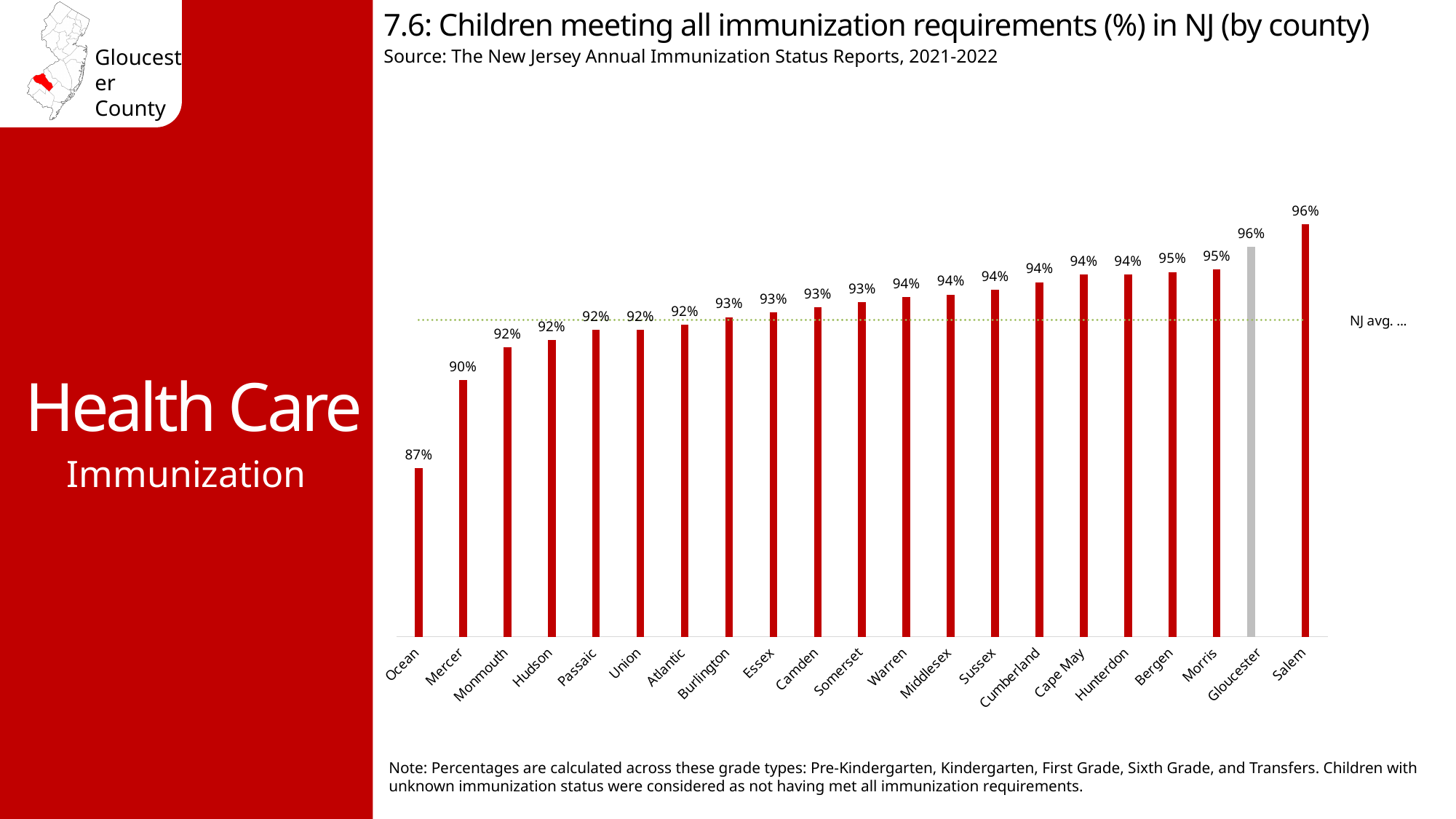
What is the difference in percentage points between Gloucester County and Ocean County? 9 percentage points What is the value shown for Ocean County? 87% Which county has the lowest percentage of children meeting all immunization requirements? Ocean What kind of chart is shown on the slide? Bar chart What is the difference in percentage points between Mercer County and Ocean County? 3 percentage points How many counties are shown on the chart? 21 What is the value shown for Bergen County? 95% What percentage of children in Gloucester County met all immunization requirements? 96% Which county has a higher value, Ocean or Hudson? Hudson Which county has a higher value, Salem or Mercer? Salem What is the value shown for Mercer County? 90% Do the values rise or fall moving from left to right along the x axis? Rise